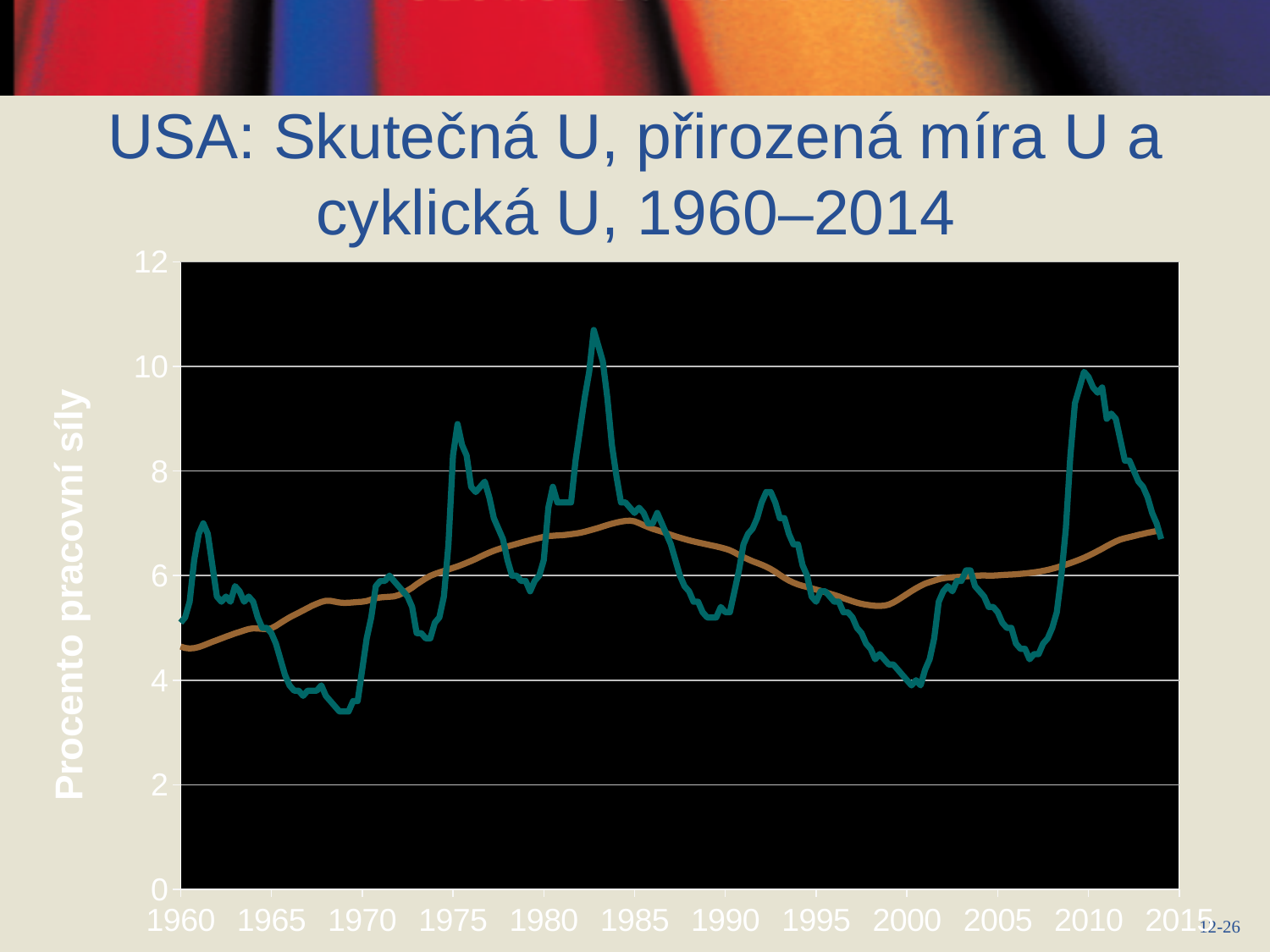
What is the label on the vertical axis of the chart? Procento pracovní síly Is the value of the brown line around 1985 greater or less than 6? greater Is the peak of the teal line around 1983 greater or less than 10? greater What is the highest value shown on the vertical axis? 12 Is the value of the teal line around 1969 greater or less than 4? less What kind of chart is shown on the slide? line chart Does the brown line rise or fall between 1960 and 1985? rise How many lines are plotted on the chart? 2 What is the title of the chart? USA: Skutečná U, přirozená míra U a cyklická U, 1960–2014